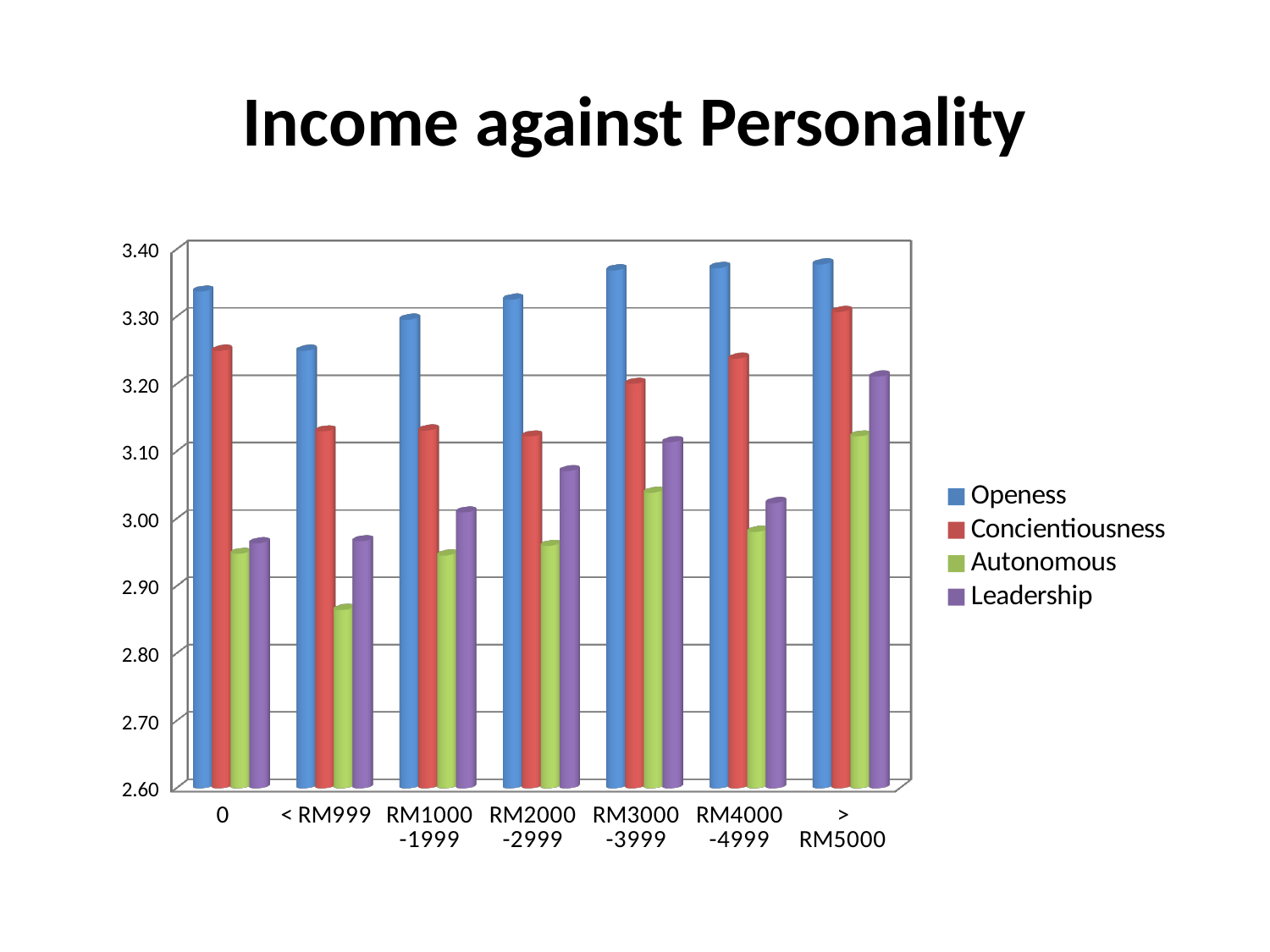
How many series does the legend list? 4 Which income group has the highest Concientiousness value? > RM5000 Which income group has the lowest Autonomous value? < RM999 Is the Concientiousness value for RM3000-3999 greater or less than 3.10? greater Which income group has the highest Leadership value? > RM5000 Is the Openess value for the 0 income group greater or less than 3.30? greater Which income group has the highest Autonomous value? > RM5000 Is the Autonomous value for < RM999 greater or less than 2.90? less How many income categories are shown on the x axis? 7 What kind of chart is shown on the slide? Bar chart For the 0 income group, which is larger: Openess or Concientiousness? Openess What is the title of the chart? Income against Personality